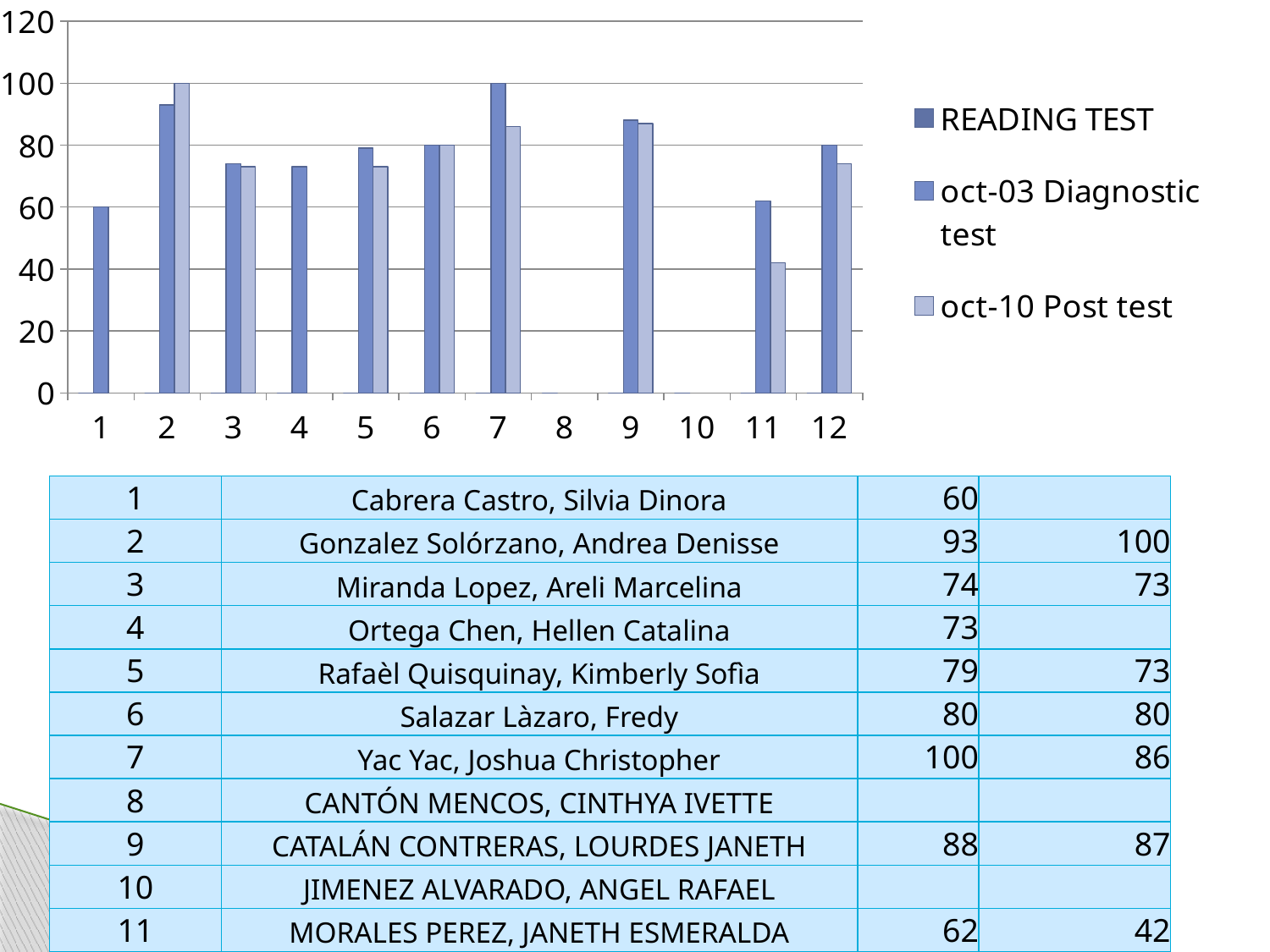
What is the third entry in the chart legend? oct-10 Post test What kind of chart is shown on the slide? bar chart What is the oct-10 Post test value for category 11? 42 Which category has the lowest oct-10 Post test value? 11 Which is larger for category 2, the oct-03 Diagnostic test value or the oct-10 Post test value? oct-10 Post test Which category has the highest oct-03 Diagnostic test value? 7 How many entries does the chart legend list? 3 Is the oct-03 Diagnostic test value for category 1 greater or less than 80? less What is the oct-03 Diagnostic test value for category 2? 93 What is the difference between the oct-03 Diagnostic test and oct-10 Post test values for category 11? 20 What is the oct-10 Post test value for category 7? 86 How many categories are shown along the x axis of the chart? 12